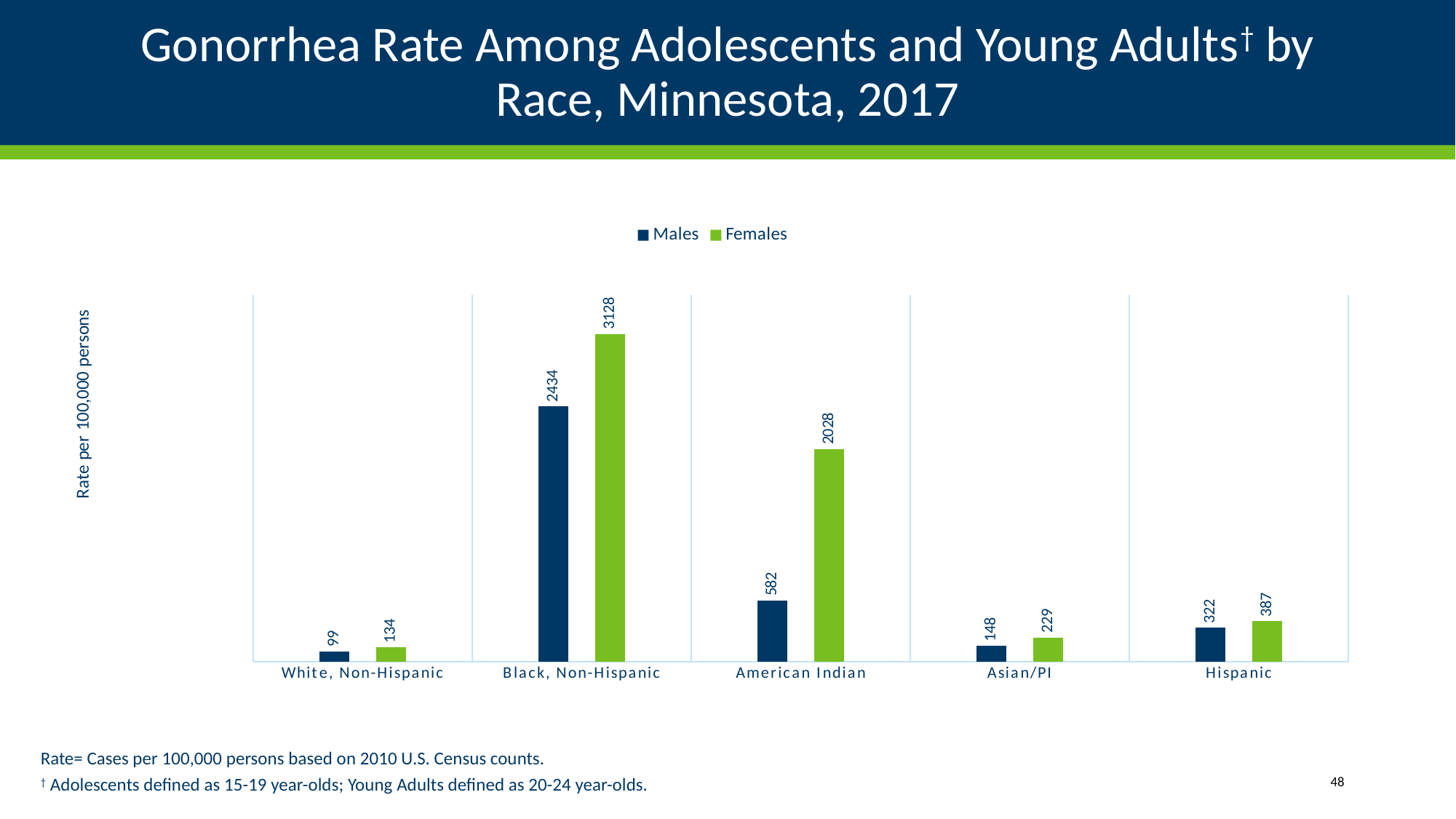
What is the difference between the female and male gonorrhea rates for Asian/PI? 81 What is the gonorrhea rate for White, Non-Hispanic males? 99 Which is larger, the male rate for Hispanic or the female rate for Asian/PI? Male rate for Hispanic What is the gonorrhea rate for Black, Non-Hispanic females? 3128 Which race category has the lowest gonorrhea rate among males? White, Non-Hispanic How many series does the legend list? 2 How many race categories are shown on the x axis? 5 What is the difference between the female and male gonorrhea rates for American Indians? 1446 What kind of chart is shown on the slide? Bar chart Which race category has the highest gonorrhea rate among females? Black, Non-Hispanic What is the gonorrhea rate for Hispanic females? 387 What is the gonorrhea rate for American Indian males? 582